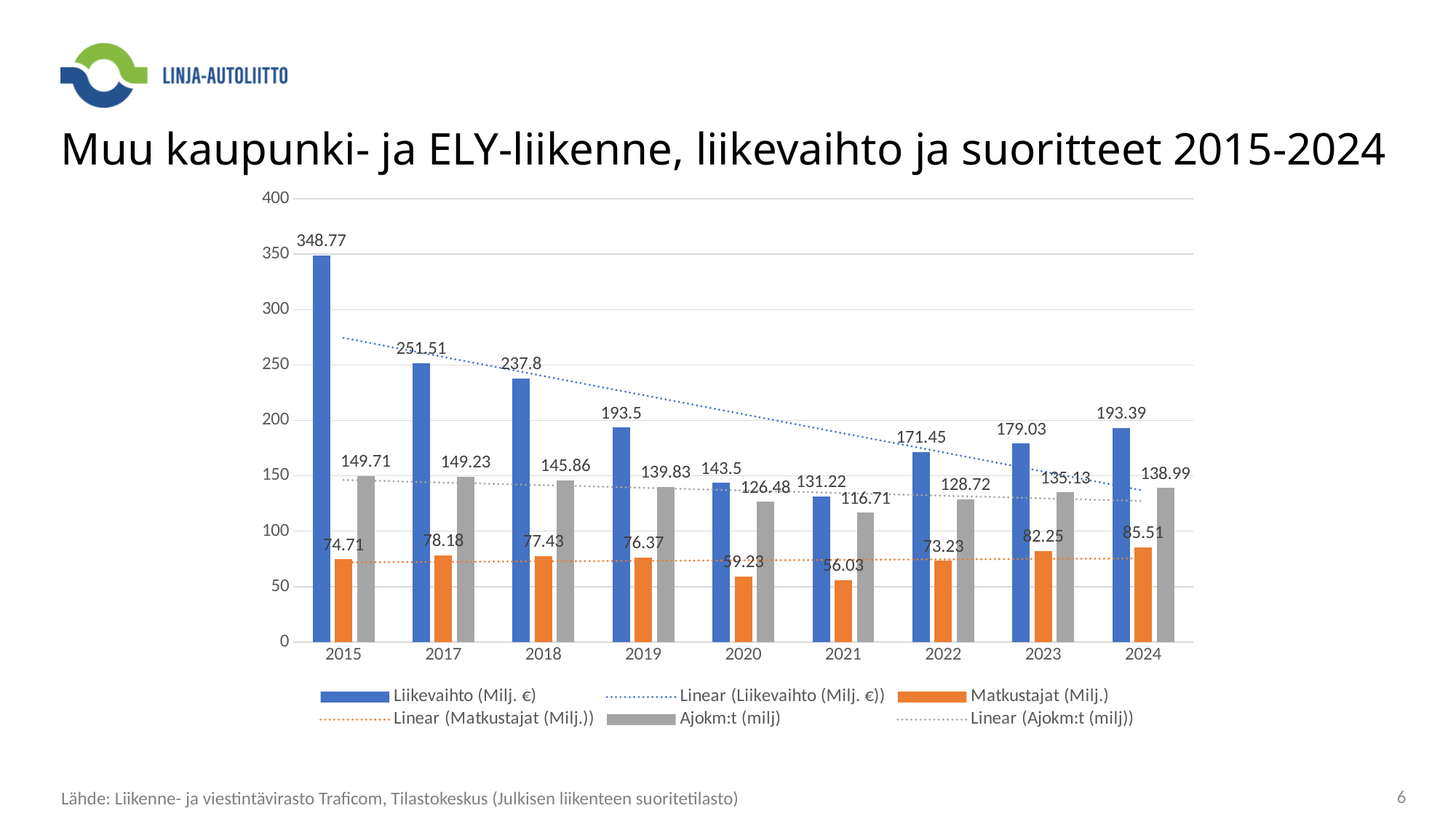
What is the Ajokm:t (milj) value for 2024? 138.99 How many years are shown on the x axis? 9 What is the difference between the Matkustajat (Milj.) values for 2024 and 2023? 3.26 In which year is Matkustajat (Milj.) lowest? 2021 In which year is Liikevaihto (Milj. €) highest? 2015 How many entries does the legend list? 6 Which year has the larger Ajokm:t (milj) value, 2015 or 2024? 2015 What is the Matkustajat (Milj.) value for 2021? 56.03 What is the difference between the Liikevaihto (Milj. €) values for 2015 and 2017? 97.26 What is the Liikevaihto (Milj. €) value for 2015? 348.77 Does Liikevaihto (Milj. €) rise or fall from 2015 to 2021? fall In which year is Ajokm:t (milj) lowest? 2021